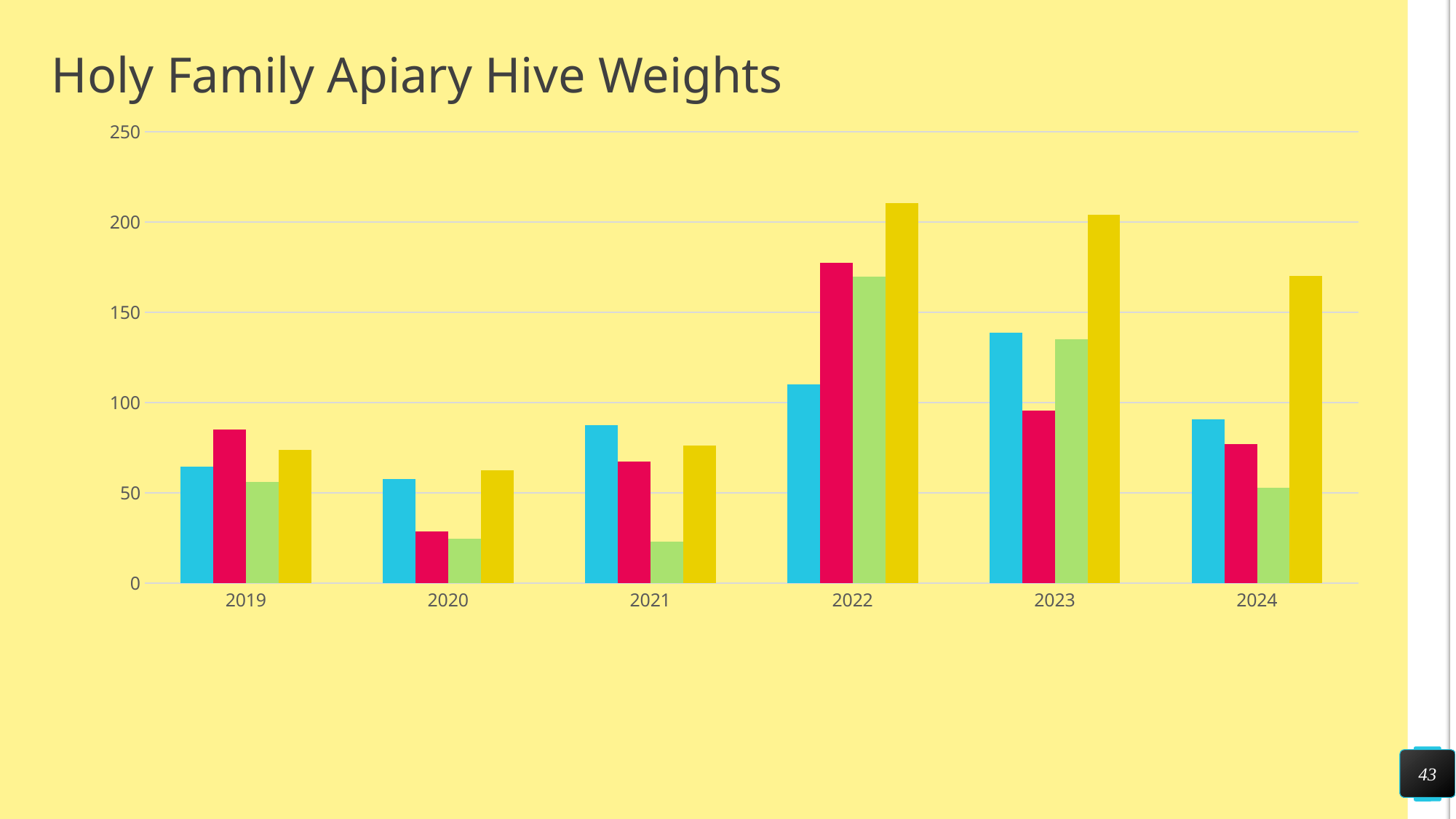
Is the value of the yellow bar for 2022 greater or less than 200? greater How many years are shown on the x axis of the chart? 6 In which year is the yellow bar the tallest? 2022 What is the title of the chart? Holy Family Apiary Hive Weights Do the blue bars rise or fall from 2020 to 2023? rise In which year is the red bar the shortest? 2020 In 2022, which is taller, the red bar or the blue bar? the red bar Is the value of the red bar for 2020 greater or less than 50? less How many bars are plotted for each year in the chart? 4 Is the value of the green bar for 2021 greater or less than 50? less What kind of chart is shown on the slide? bar chart